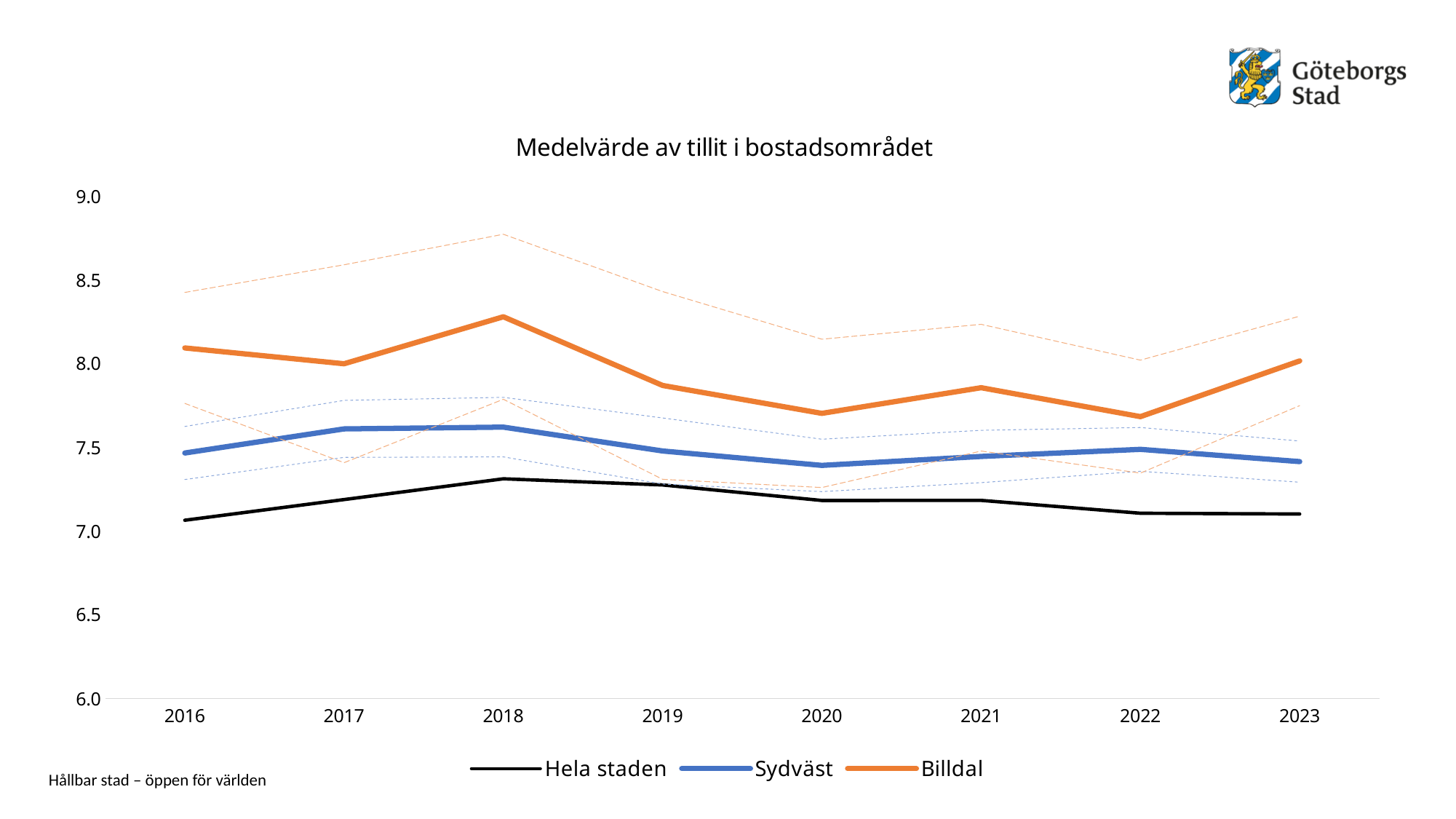
How many years are shown along the x axis? 8 How many series does the legend list? 3 Does the Hela staden line rise or fall from 2018 to 2022? fall What is the title of the chart? Medelvärde av tillit i bostadsområdet Is the value for Sydväst in 2017 greater or less than 7.5? greater Is the value for Billdal in 2018 greater or less than 8.0? greater Is the value for Hela staden in 2016 greater or less than 7.5? less What kind of chart is shown on the slide? line chart In 2020, which is larger: the value for Sydväst or the value for Hela staden? Sydväst Which series has the highest value in 2018? Billdal Which series has the lowest value in 2023? Hela staden